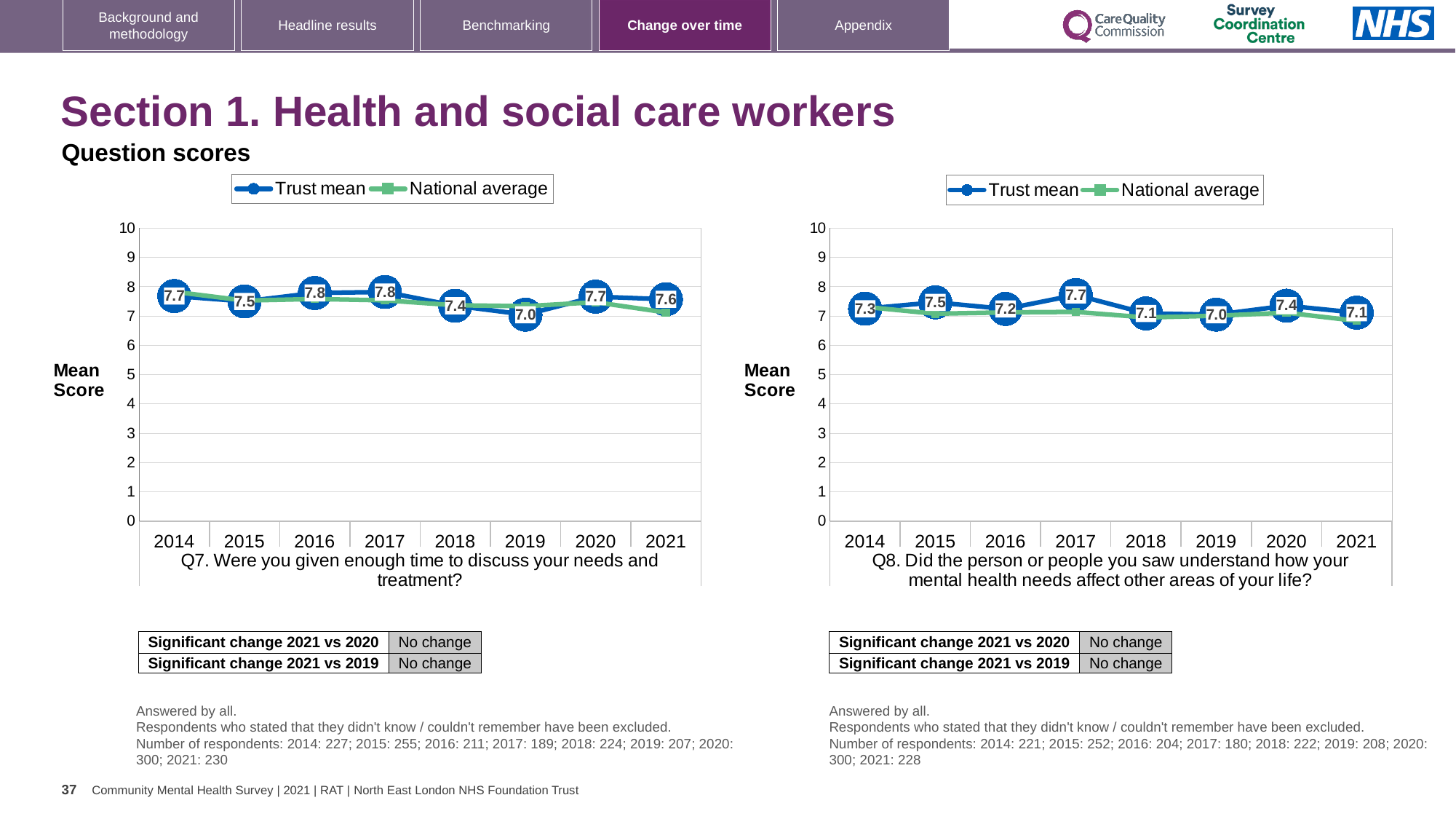
In the Q8 chart, which year has the lowest Trust mean? 2019 In the Q7 chart, which year has the lowest Trust mean? 2019 In the Q7 chart, what is the difference between the Trust mean in 2017 and in 2019? 0.8 What type of chart is the Q7 chart? Line chart How many series does the legend of the Q8 chart list? 2 In the Q7 chart, what is the Trust mean for 2021? 7.6 In the Q7 chart, what is the Trust mean for 2019? 7.0 In the Q8 chart, is the Trust mean higher in 2015 or in 2016? 2015 In the Q8 chart, what is the Trust mean for 2017? 7.7 In the Q7 chart, how many years are shown on the x axis? 8 In the Q8 chart, what is the difference between the Trust mean in 2020 and in 2021? 0.3 In the Q8 chart, which year has the highest Trust mean? 2017